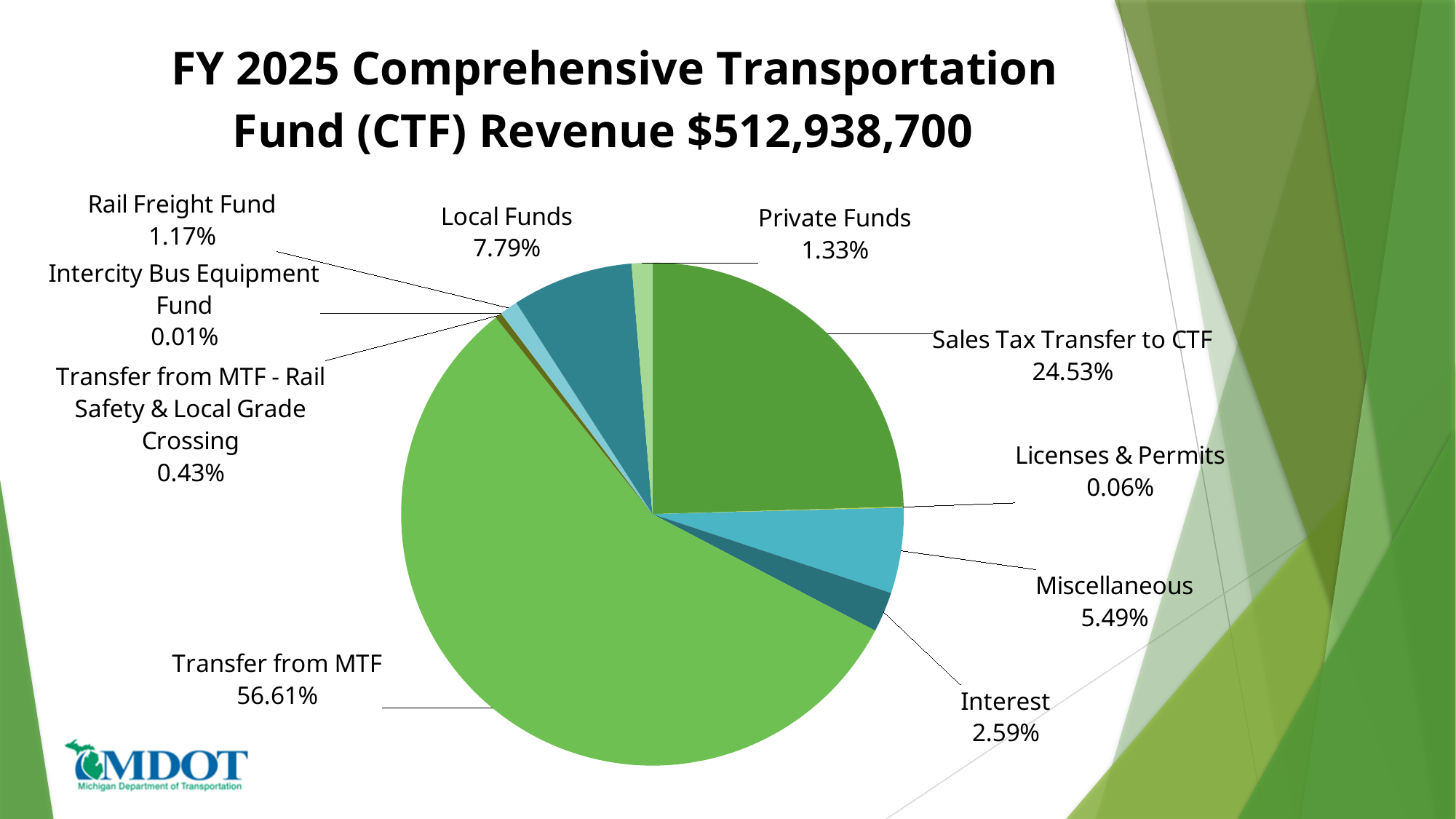
How many categories are shown in the pie chart? 10 What is the value shown for Sales Tax Transfer to CTF? 24.53% What share of the pie does Transfer from MTF represent? 56.61% What kind of chart is shown on the slide? pie chart What is the difference between the shares for Transfer from MTF and Sales Tax Transfer to CTF? 32.08% What is the value shown for Miscellaneous? 5.49% What is the value shown for Intercity Bus Equipment Fund? 0.01% What total revenue amount is stated in the chart title? $512,938,700 Which category has the largest share of the pie? Transfer from MTF Which is larger, the share for Interest or the share for Private Funds? Interest What is the value shown for Local Funds? 7.79% Which category has the smallest share of the pie? Intercity Bus Equipment Fund